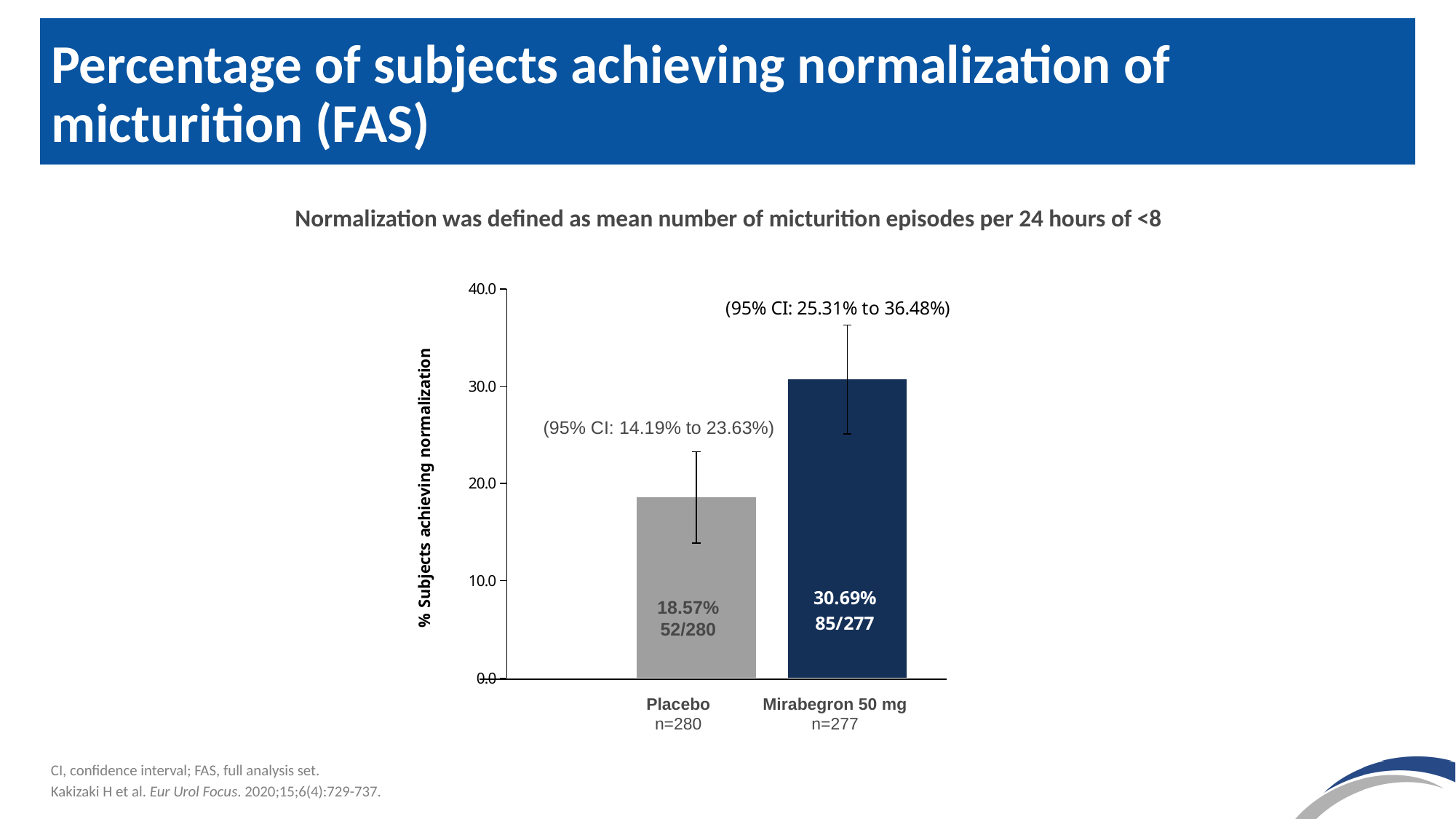
Which group has the higher percentage of subjects achieving normalization? Mirabegron 50 mg How many subjects out of the total achieved normalization in the Placebo group? 52/280 What percentage of subjects achieved normalization in the Placebo group? 18.57% What is the 95% confidence interval shown for the Mirabegron 50 mg group? 25.31% to 36.48% Is the value for Mirabegron 50 mg greater or less than 30.0? greater How many groups are shown on the chart? 2 What is the difference in percentage points between the Mirabegron 50 mg and Placebo groups? 12.12 How many subjects out of the total achieved normalization in the Mirabegron 50 mg group? 85/277 What type of chart is shown on the slide? Bar chart What percentage of subjects achieved normalization in the Mirabegron 50 mg group? 30.69% Which group has the lower percentage of subjects achieving normalization? Placebo Is the value for Placebo greater or less than 20.0? less